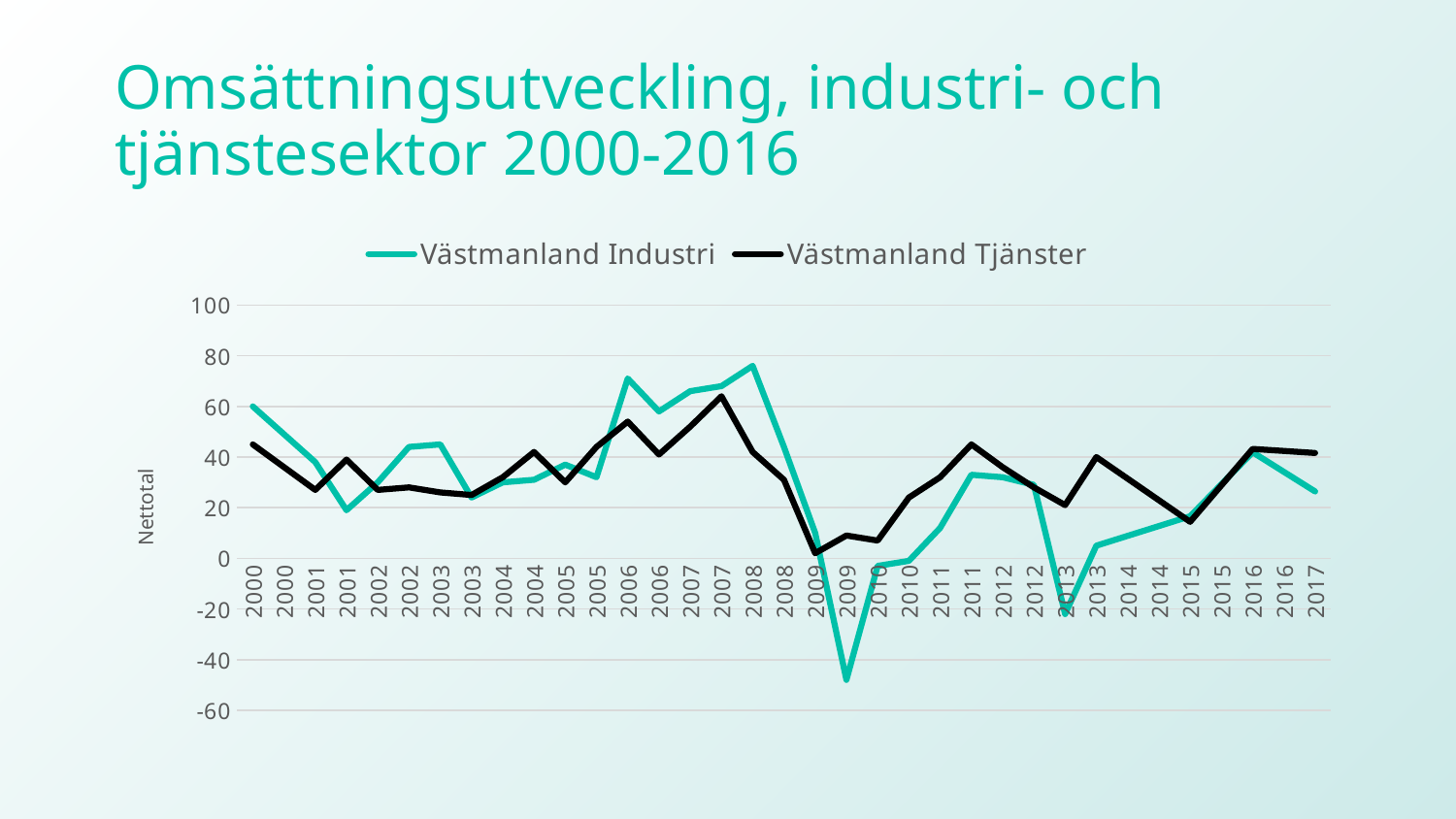
In which year does the Västmanland Industri series reach its highest value? 2008 What label is shown on the vertical axis? Nettotal In which year does the Västmanland Industri series reach its lowest value? 2009 Is the peak value of Västmanland Industri in 2008 greater or less than 60? greater What kind of chart is shown on the slide? Line chart Does the Västmanland Industri series rise or fall between 2008 and 2009? Fall At the first 2008 point, which series has the higher value, Västmanland Industri or Västmanland Tjänster? Västmanland Industri How many series does the legend list? 2 What is the title of the chart on the slide? Omsättningsutveckling, industri- och tjänstesektor 2000-2016 Is the lowest value of Västmanland Industri (in 2009) greater or less than -40? less Is the value of Västmanland Tjänster at the first 2009 point greater or less than 20? less At the second 2009 point, which series has the higher value, Västmanland Industri or Västmanland Tjänster? Västmanland Tjänster